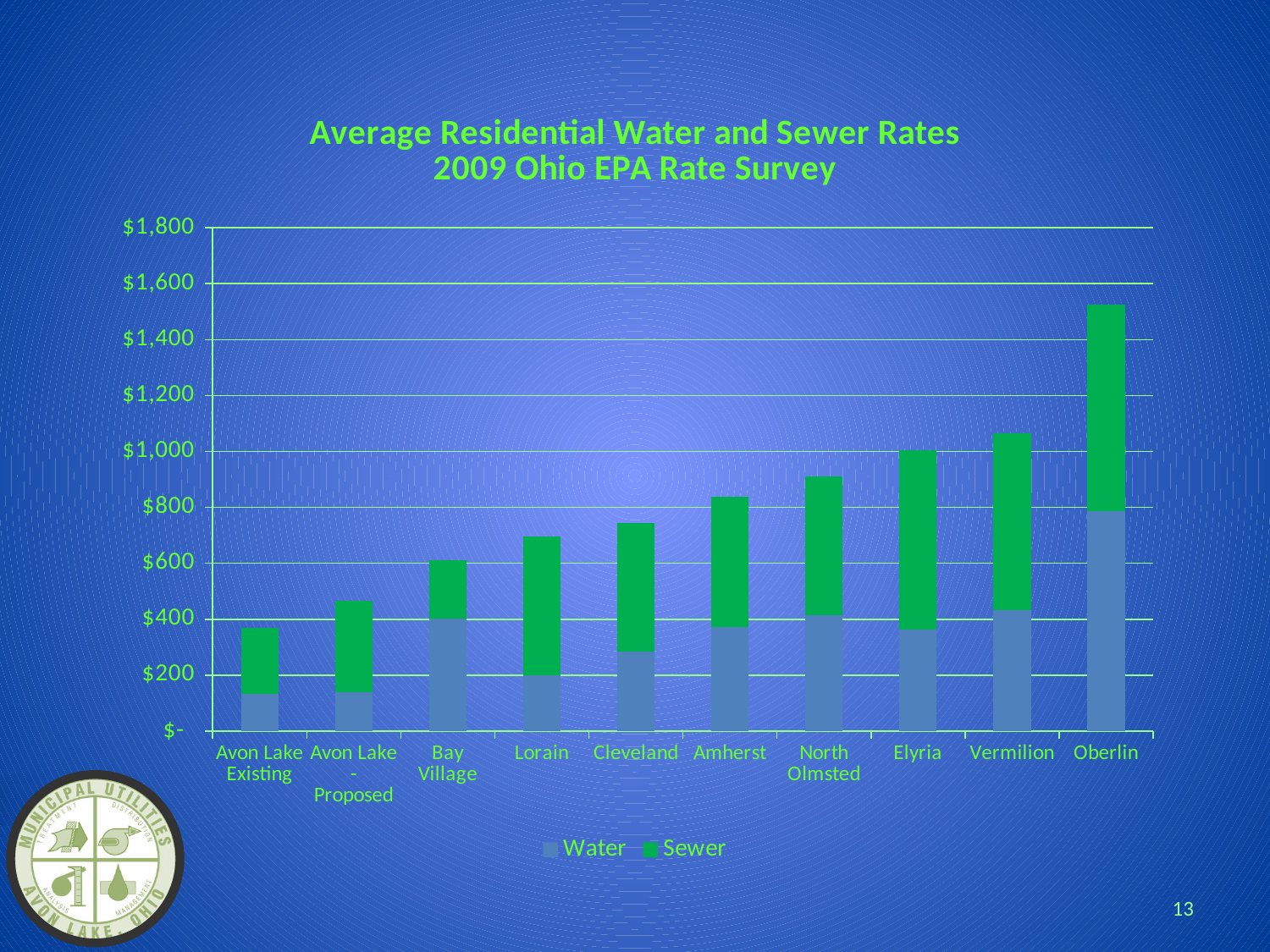
What are the two series named in the legend? Water and Sewer How many series does the legend list? 2 Is the total bar for Oberlin greater or less than $1,400? greater Which community has the lowest total water and sewer rate? Avon Lake Existing How many communities (categories) are shown on the x axis? 10 What kind of chart is shown on the slide? Stacked bar chart Do the total bar heights generally rise or fall from left to right across the x axis? Rise Which has a larger total rate, Vermilion or Cleveland? Vermilion Is the Water portion for Lorain greater or less than $400? less Is the total bar for Avon Lake Existing greater or less than $400? less Which community has the highest total water and sewer rate? Oberlin